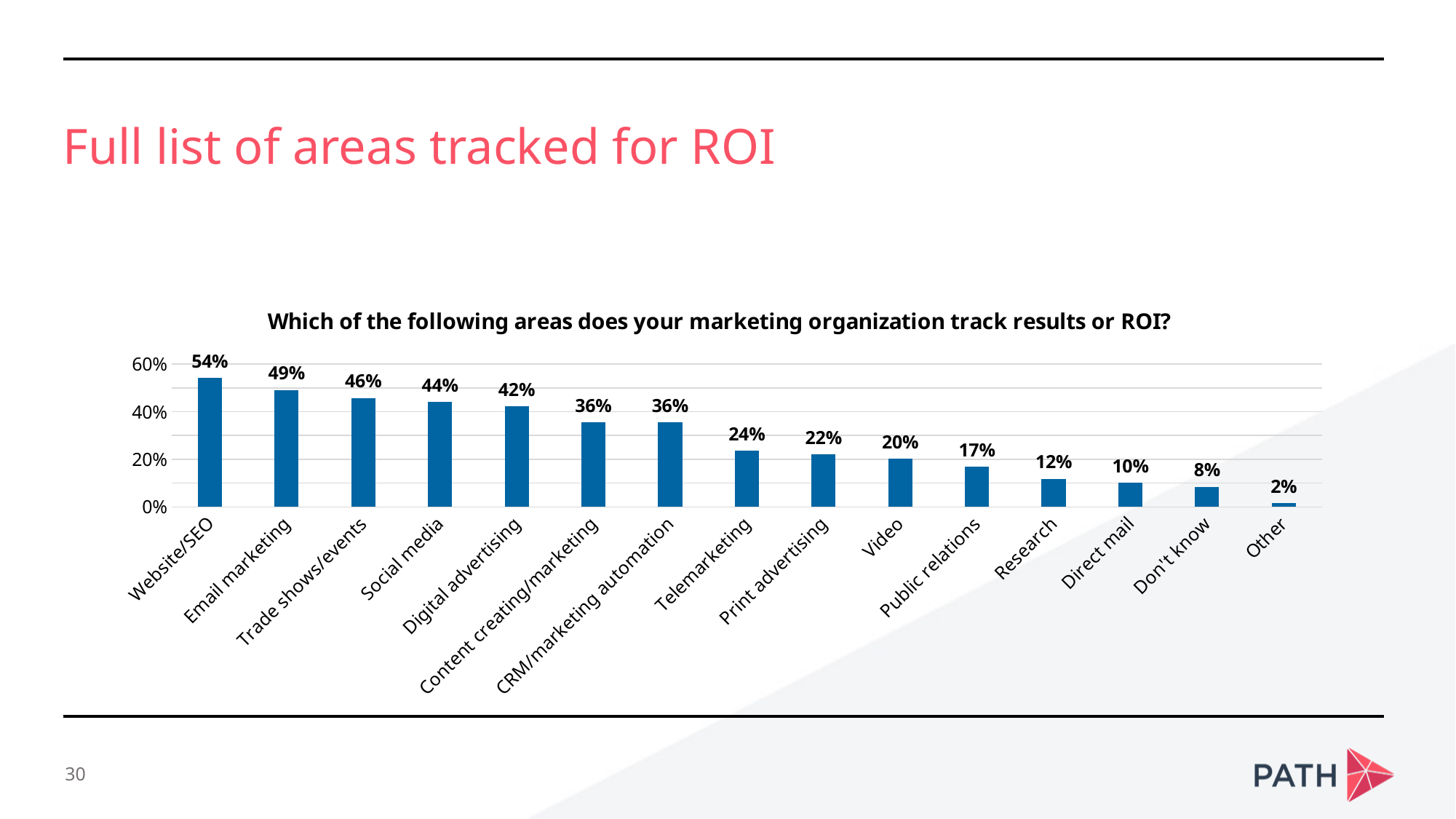
What is the difference in percentage points between Email marketing and Social media? 5% Is the value for Print advertising greater or less than 40%? less How many areas (categories) are shown in the chart? 15 Which area has the highest percentage in the chart? Website/SEO What is the difference between Video and Research? 8% What percentage of marketing organizations track results or ROI for Website/SEO? 54% What is the value shown for Direct mail? 10% Do the values rise or fall moving from left to right along the x axis? Fall What is the value shown for Telemarketing? 24% What type of chart is shown on the slide? Bar chart Which is larger, Trade shows/events or Digital advertising? Trade shows/events Which area has the lowest percentage in the chart? Other